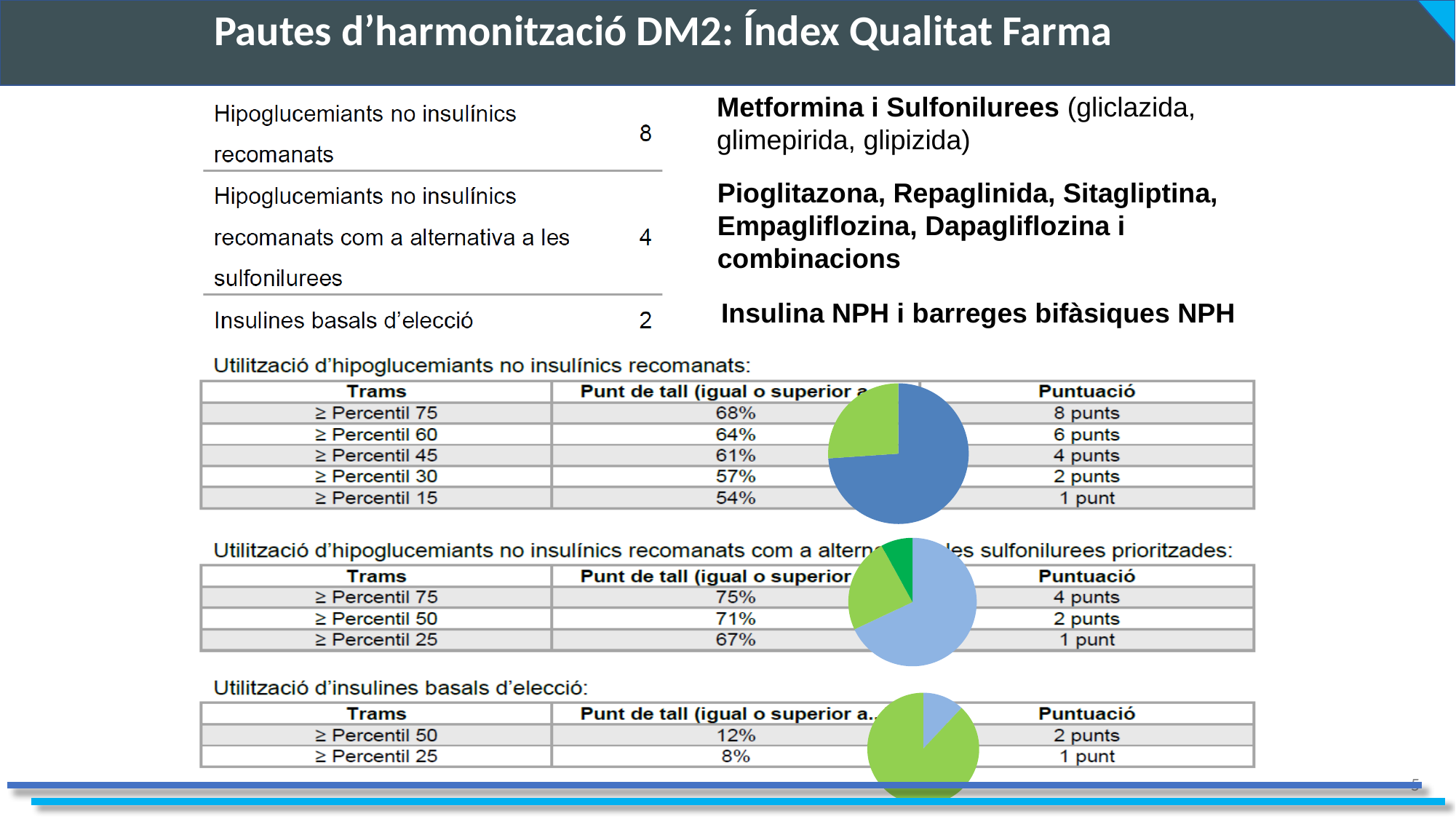
How many slices does the bottom pie chart have? 2 In the top pie chart, is the blue slice or the green slice larger? blue How many pie charts are shown on the slide? 3 In the middle pie chart, which colour slice is the largest? light blue In the bottom pie chart, which colour slice is the largest? green In the top pie chart, which colour slice is the largest? blue Do the pie charts on the slide have a legend? No How many slices does the top pie chart have? 2 What kind of chart is the chart overlapping the top table (Utilització d'hipoglucemiants no insulínics recomanats)? pie chart In the middle pie chart, which colour slice is the smallest? dark green In the bottom pie chart, is the green slice or the light blue slice larger? green